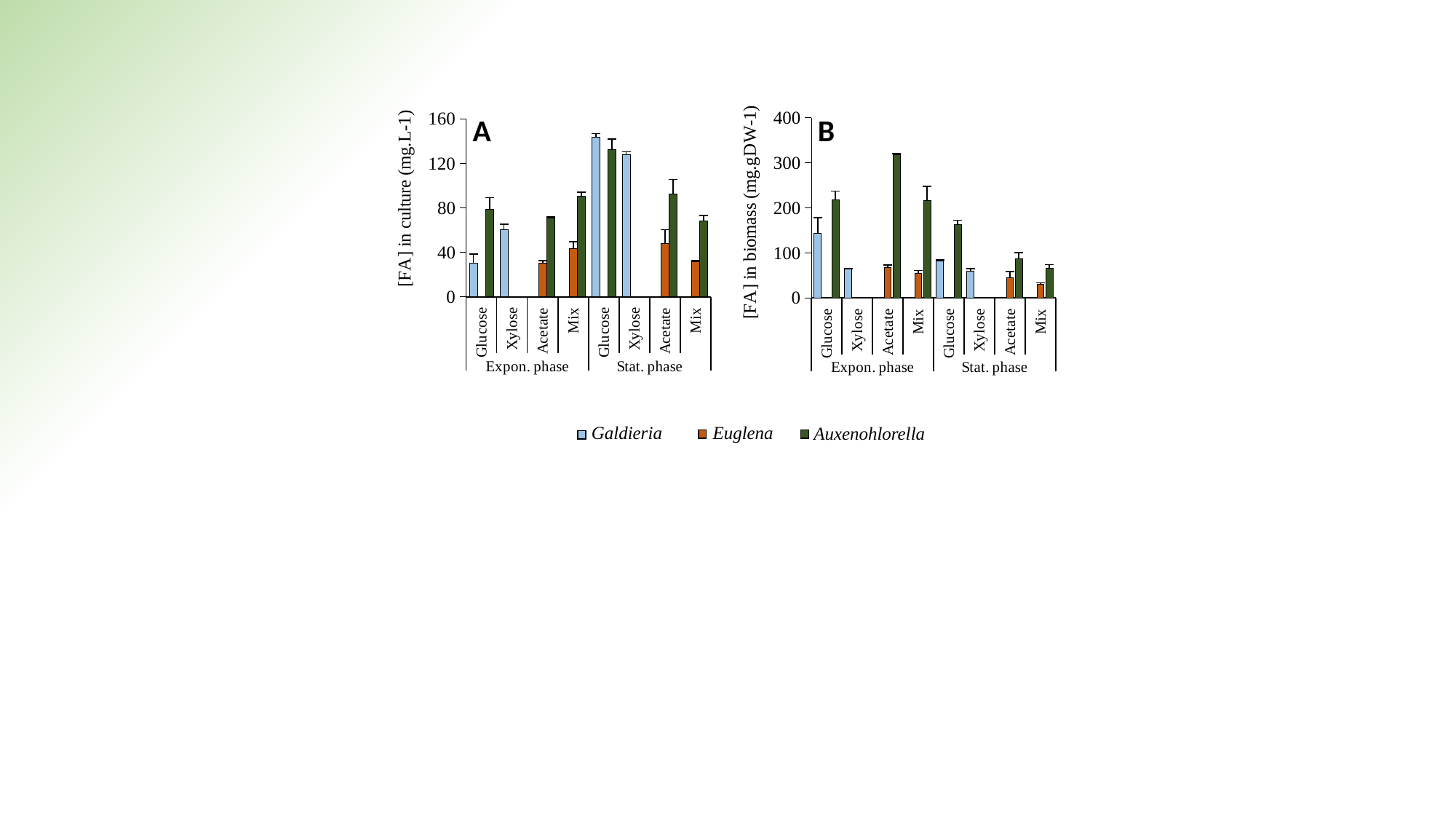
In chart A, for Glucose in the Expon. phase, which is larger: Galdieria or Auxenohlorella? Auxenohlorella In chart B, which substrate and phase has the tallest bar? Acetate, Expon. phase What is the y-axis label of chart B? [FA] in biomass (mg.gDW-1) In chart B, is the Auxenohlorella value for Acetate in the Expon. phase greater or less than 300? greater How many series does the legend list? 3 In chart B, is the Euglena value for Mix in the Stat. phase greater or less than 100? less Which series is shown in orange in the legend? Euglena In chart A, is the Galdieria value for Glucose in the Stat. phase greater or less than 120? greater What kind of chart is chart A? bar chart In chart B, for Mix in the Expon. phase, which is larger: Euglena or Auxenohlorella? Auxenohlorella In chart A, how many substrate categories are shown along the x axis across both phases? 8